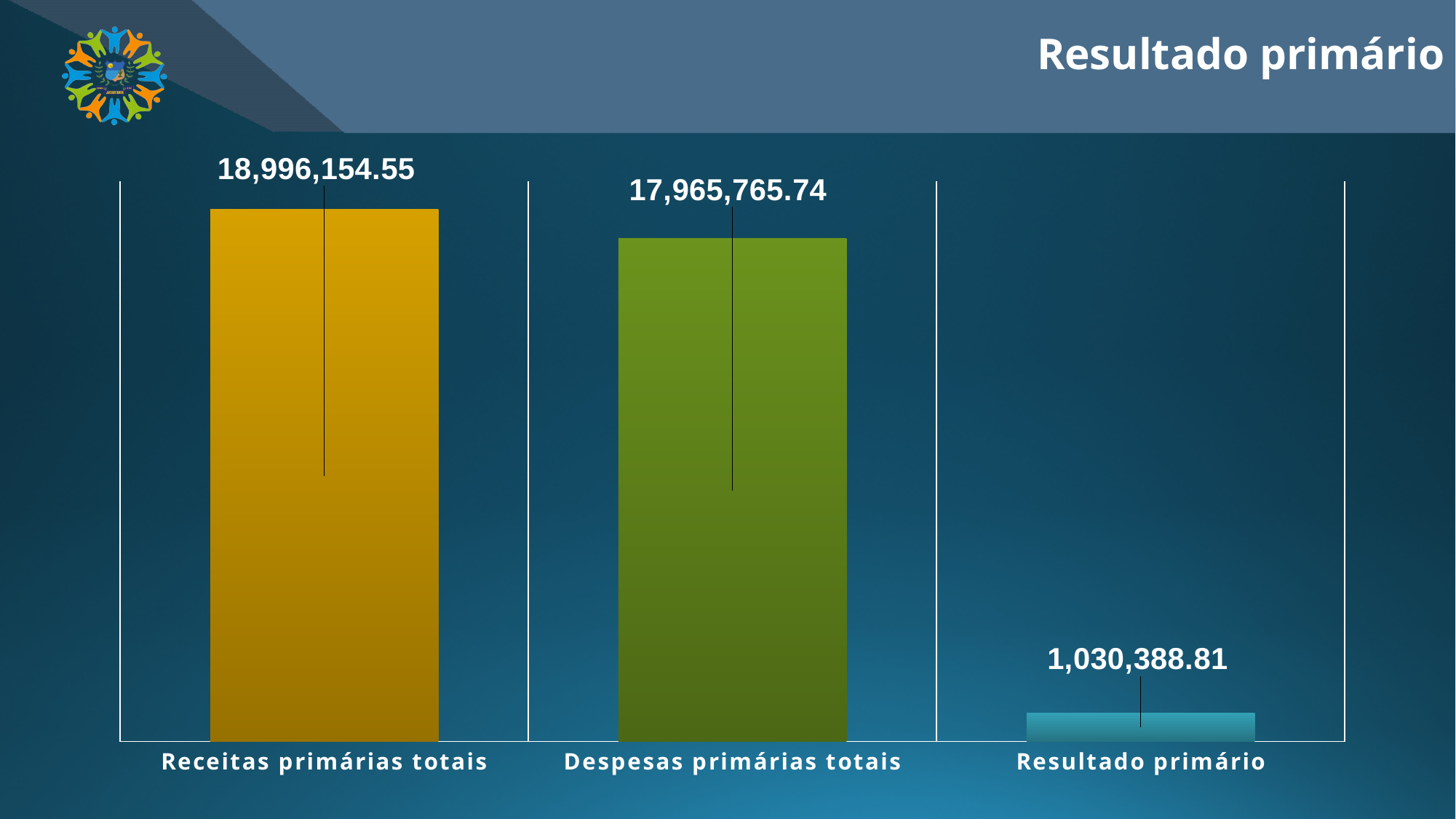
What is the difference between Despesas primárias totais and Resultado primário? 16,935,376.93 What is the value for Resultado primário? 1,030,388.81 Which category has the lowest value? Resultado primário What is the value for Receitas primárias totais? 18,996,154.55 Which category has the highest value? Receitas primárias totais What is the value for Despesas primárias totais? 17,965,765.74 What is the difference between Receitas primárias totais and Despesas primárias totais? 1,030,388.81 How many categories are shown in the chart? 3 Which is larger, Receitas primárias totais or Despesas primárias totais? Receitas primárias totais Which is larger, Despesas primárias totais or Resultado primário? Despesas primárias totais What kind of chart is shown on the slide? Bar chart What is the title of the slide? Resultado primário